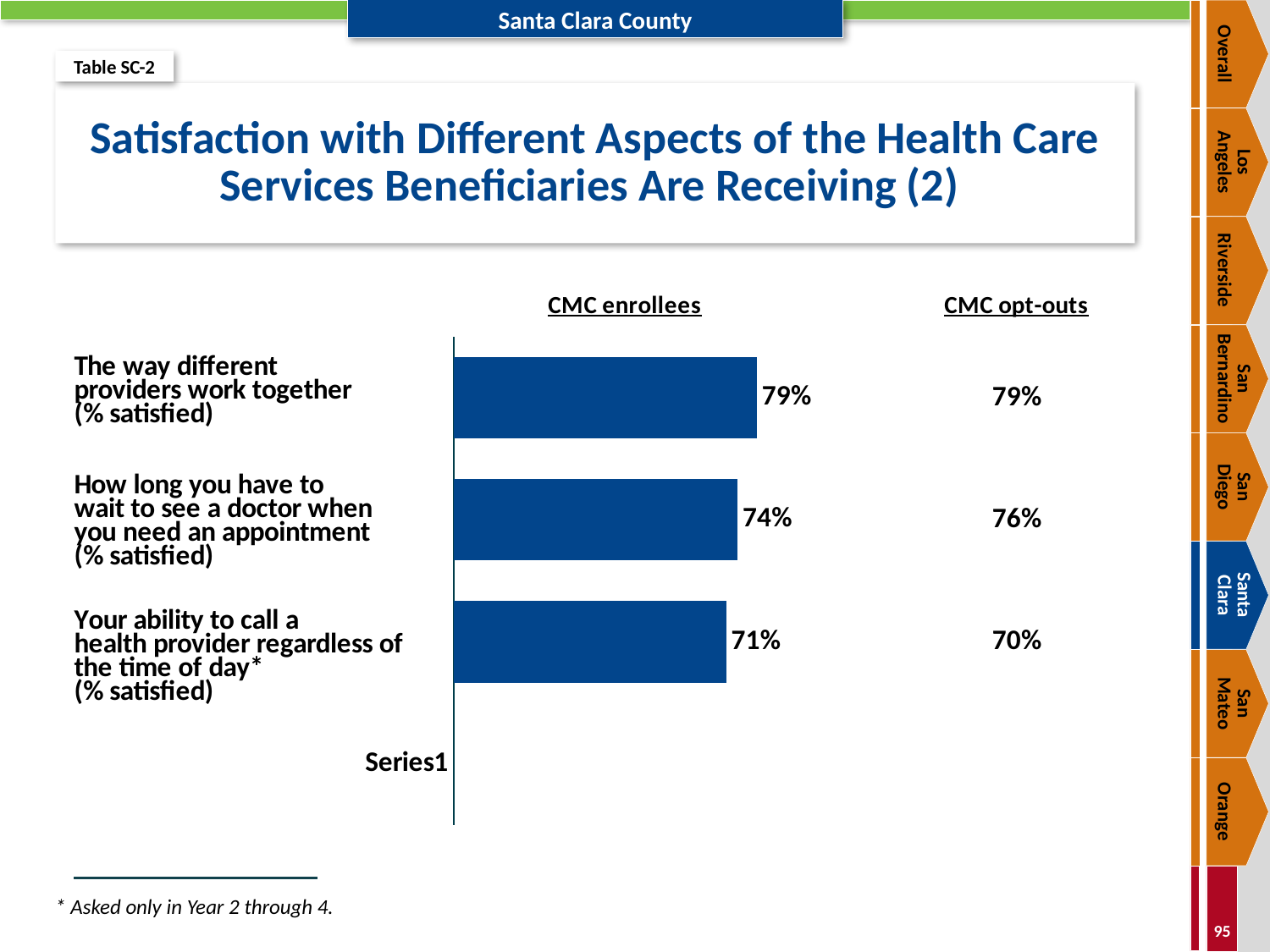
What kind of chart is shown on the slide? bar chart Which aspect has the highest satisfaction among CMC enrollees? The way different providers work together For your ability to call a health provider regardless of the time of day, which group has the higher satisfaction: CMC enrollees or CMC opt-outs? CMC enrollees What is the title of the chart on the slide? Satisfaction with Different Aspects of the Health Care Services Beneficiaries Are Receiving (2) What percentage of CMC enrollees are satisfied with the way different providers work together? 79% What percentage of CMC enrollees are satisfied with how long they have to wait to see a doctor when they need an appointment? 74% What percentage of CMC enrollees are satisfied with their ability to call a health provider regardless of the time of day? 71% What is the difference in percentage points between CMC enrollees satisfied with the way providers work together and those satisfied with their ability to call a health provider regardless of the time of day? 8 How many aspects of health care services are plotted as bars in the chart? 3 What percentage of CMC opt-outs are satisfied with how long they have to wait to see a doctor when they need an appointment? 76% Which aspect has the lowest satisfaction among CMC enrollees? Your ability to call a health provider regardless of the time of day For how long you have to wait to see a doctor, which group has the higher satisfaction: CMC enrollees or CMC opt-outs? CMC opt-outs